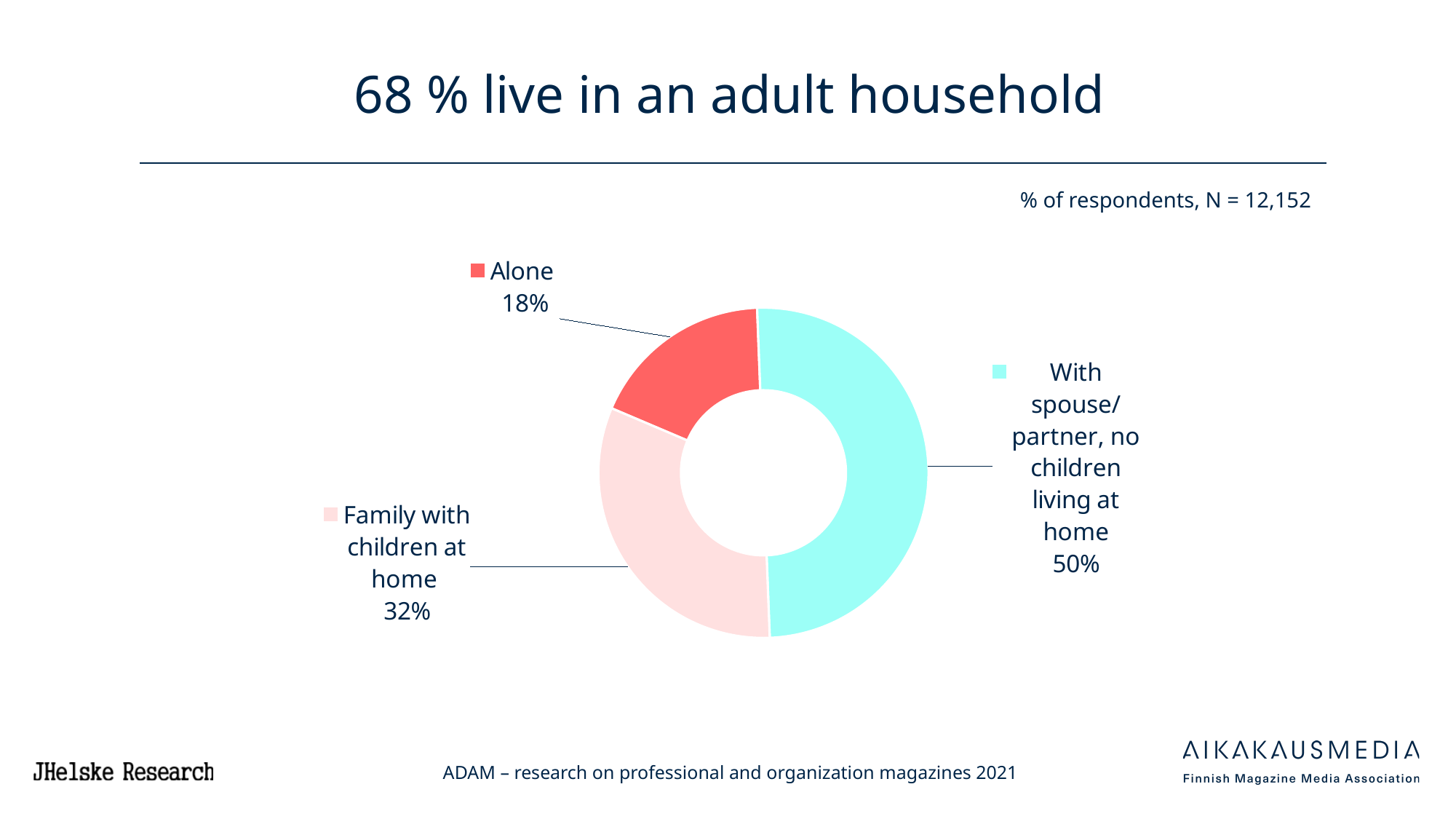
What kind of chart is shown on the slide? Pie chart (doughnut) What is the number of respondents (N) stated on the slide? 12,152 What is the title of the slide? 68 % live in an adult household Which is larger: the share living alone or the share living in a family with children at home? Family with children at home Which category has the smallest share of respondents? Alone What is the combined share of respondents living alone or with a spouse/partner with no children at home? 68% How many categories does the chart show? 3 What percentage of respondents live alone? 18% How many percentage points larger is the 'Family with children at home' share than the 'Alone' share? 14 What percentage of respondents live with a spouse/partner with no children living at home? 50% What percentage of respondents live in a family with children at home? 32% Which category has the largest share of respondents? With spouse/partner, no children living at home